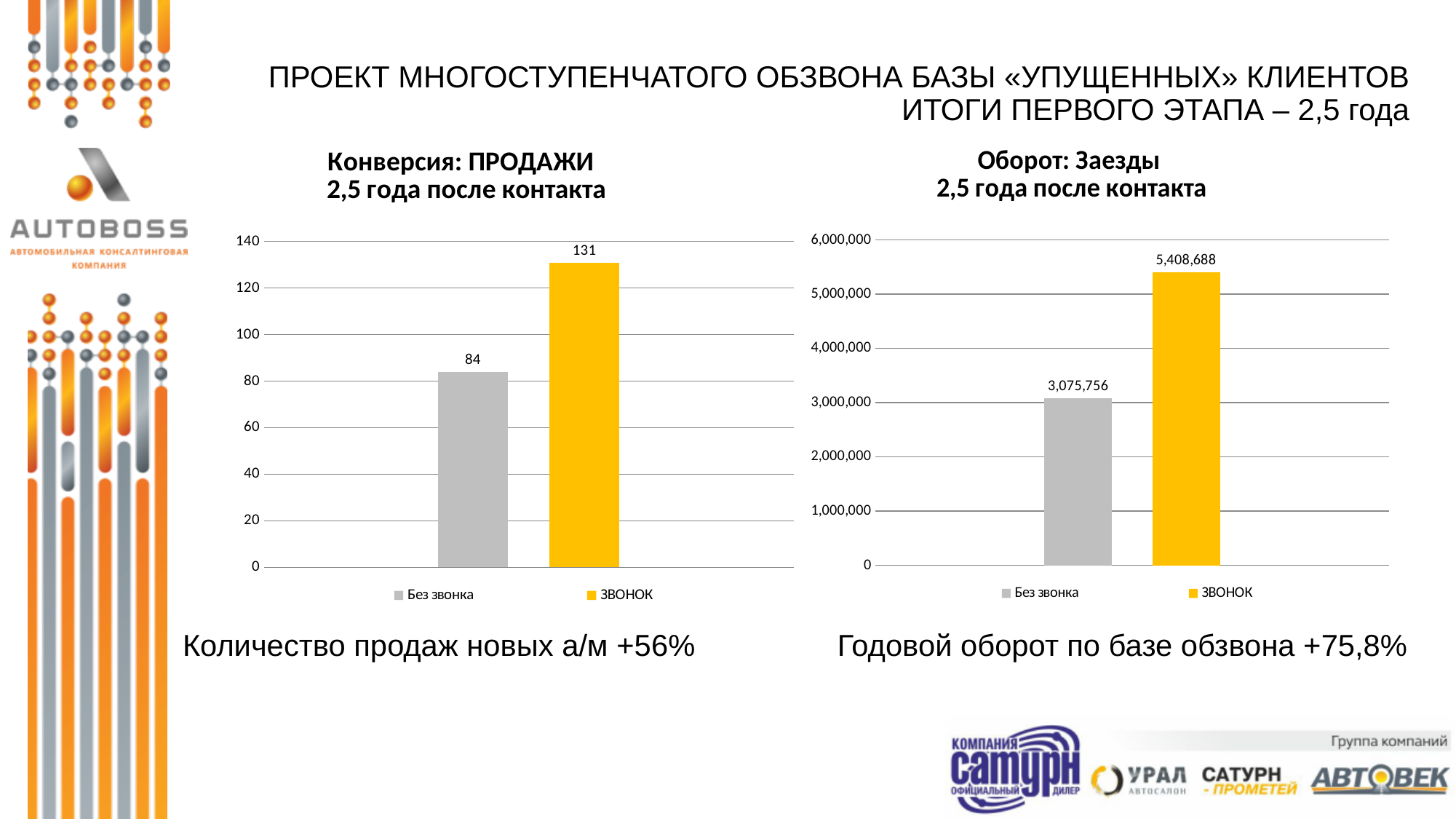
In the left chart (Конверсия: ПРОДАЖИ), what is the value for ЗВОНОК? 131 In the left chart (Конверсия: ПРОДАЖИ), what is the difference between ЗВОНОК and Без звонка? 47 In the right chart (Оборот: Заезды), is the value for ЗВОНОК greater or less than 5,000,000? greater In the left chart (Конверсия: ПРОДАЖИ), what is the value for Без звонка? 84 How many series does the legend of the left chart (Конверсия: ПРОДАЖИ) list? 2 In the right chart (Оборот: Заезды), what is the value for ЗВОНОК? 5,408,688 In the left chart (Конверсия: ПРОДАЖИ), which series has the higher value? ЗВОНОК What kind of chart is the right chart (Оборот: Заезды)? bar chart In the right chart (Оборот: Заезды), what is the value for Без звонка? 3,075,756 In the right chart (Оборот: Заезды), what is the difference between ЗВОНОК and Без звонка? 2,332,932 In the left chart (Конверсия: ПРОДАЖИ), what colour is the ЗВОНОК bar? yellow In the right chart (Оборот: Заезды), which series has the lower value? Без звонка